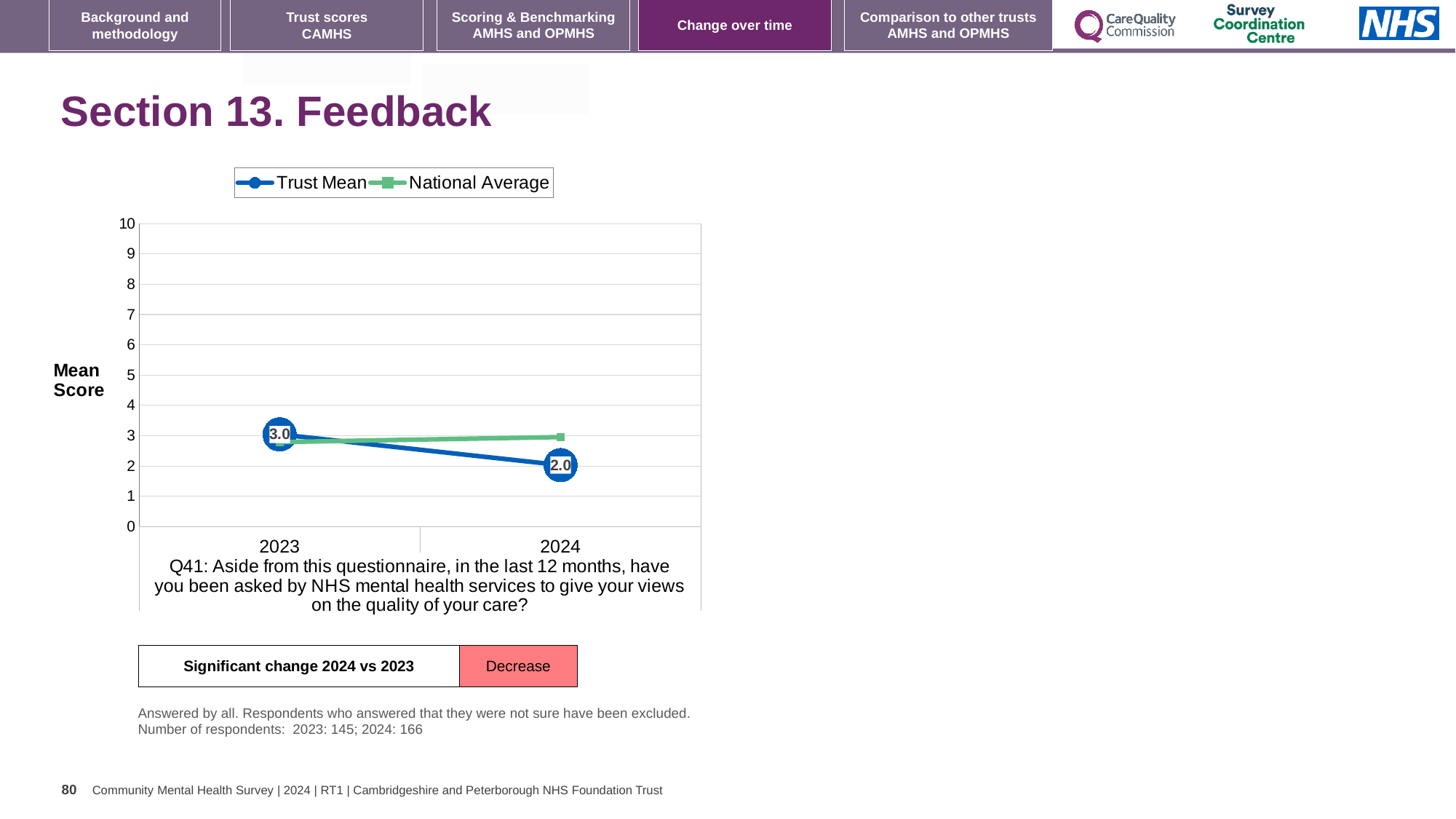
How many years are plotted on the x axis of the chart? 2 What does the 'Significant change 2024 vs 2023' box below the chart say? Decrease By how much did the Trust Mean score change from 2023 to 2024? 1.0 Does the Trust Mean rise or fall from 2023 to 2024? fall Is the National Average value for 2023 greater or less than 4? less What is the Trust Mean score for 2023? 3.0 What kind of chart is shown on the slide? line chart How many series does the chart legend list? 2 In 2024, which is larger: the Trust Mean or the National Average? National Average Is the National Average value for 2024 greater or less than 2? greater What is the Trust Mean score for 2024? 2.0 In which year is the Trust Mean score higher? 2023